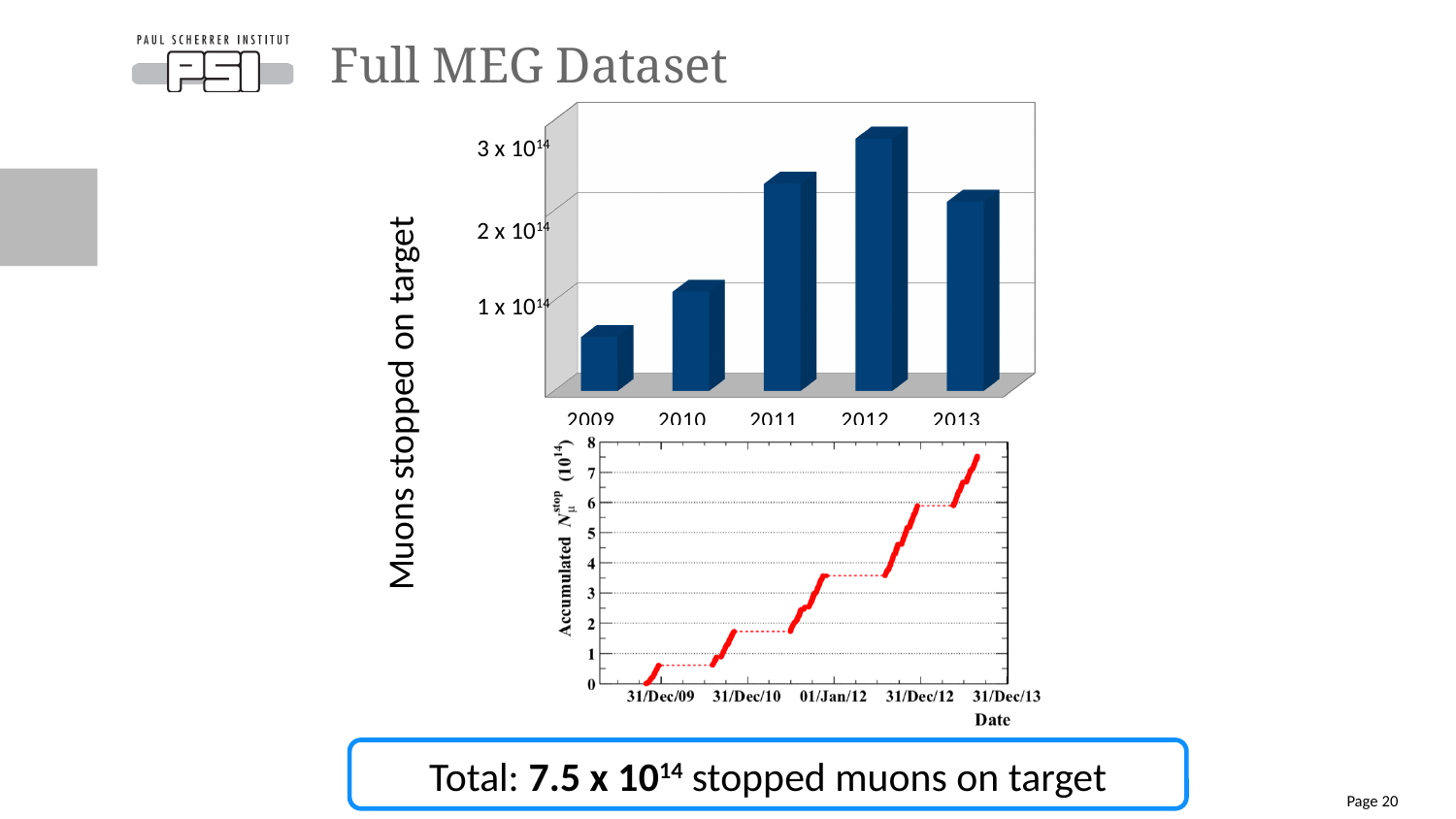
In the top bar chart, which year has the highest number of muons stopped on target? 2012 In the top bar chart, which year has the lowest number of muons stopped on target? 2009 In the top bar chart, is the value for 2009 greater or less than 1 x 10^14? less In the bottom line chart, what is the label of the x axis? Date What kind of chart is the bottom chart on the slide? line chart In the top bar chart, is the value for 2013 greater or less than 1 x 10^14? greater In the top bar chart, which year has the larger value, 2010 or 2011? 2011 In the top bar chart, is the value for 2011 greater or less than 2 x 10^14? greater In the bottom line chart, does the accumulated number of stopped muons rise or fall over time? rise What kind of chart is the top chart on the slide? bar chart In the top bar chart, which year has the larger value, 2012 or 2013? 2012 In the top bar chart, how many years are shown on the x axis? 5